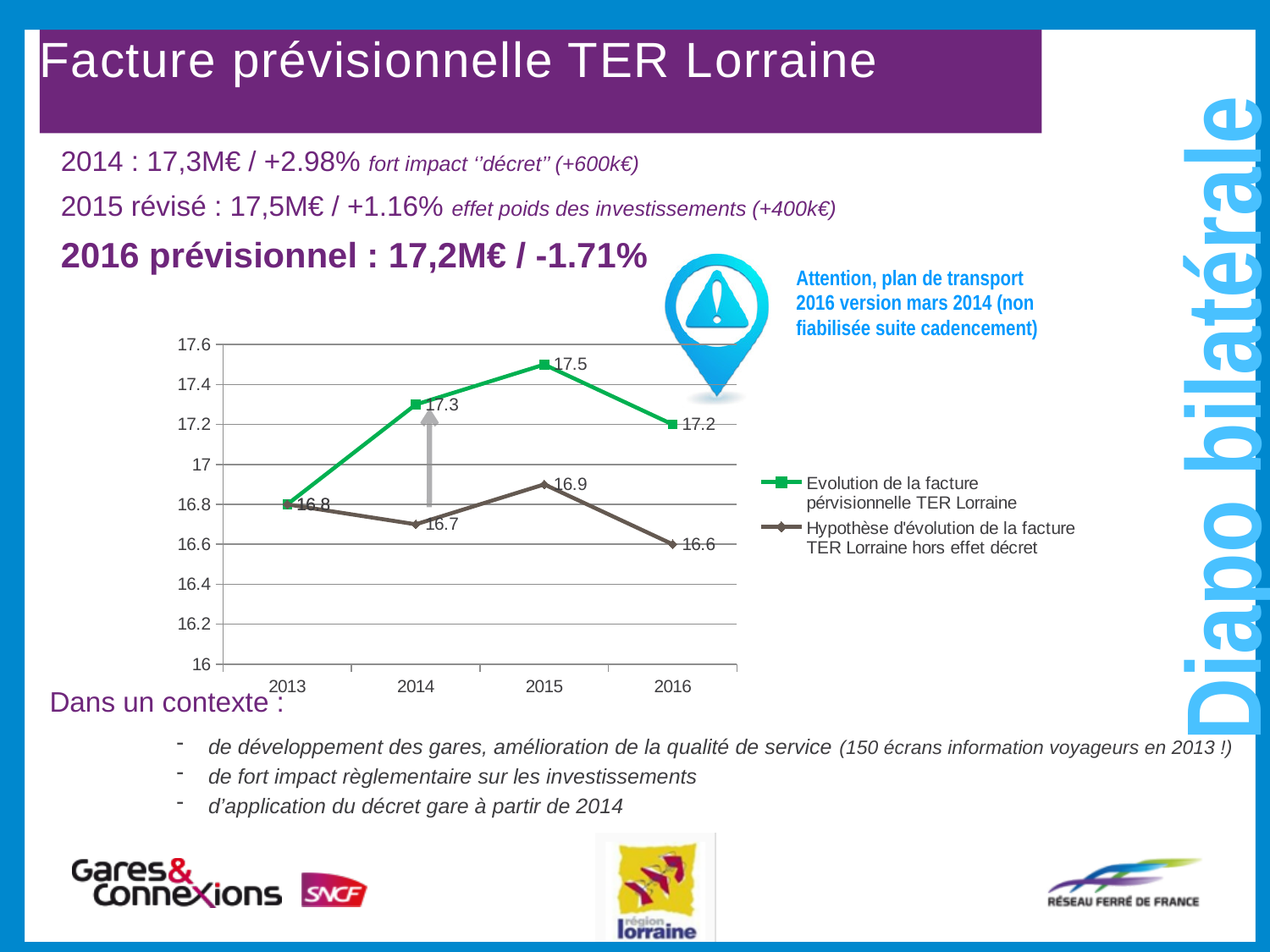
What is the difference between the two series in 2014? 0.6 What is the value of 'Hypothèse d'évolution de la facture TER Lorraine hors effet décret' in 2016? 16.6 What type of chart is shown on the slide? line chart Which series has the higher value in 2016? Evolution de la facture pérvisionnelle TER Lorraine How many years are plotted along the x axis of the chart? 4 Does 'Evolution de la facture pérvisionnelle TER Lorraine' rise or fall between 2015 and 2016? fall In which year is 'Hypothèse d'évolution de la facture TER Lorraine hors effet décret' at its lowest? 2016 In which year does 'Evolution de la facture pérvisionnelle TER Lorraine' reach its highest value? 2015 What is the value of 'Evolution de la facture pérvisionnelle TER Lorraine' in 2016? 17.2 How many series does the chart legend list? 2 What is the value of 'Hypothèse d'évolution de la facture TER Lorraine hors effet décret' in 2014? 16.7 What is the value of 'Evolution de la facture pérvisionnelle TER Lorraine' in 2015? 17.5